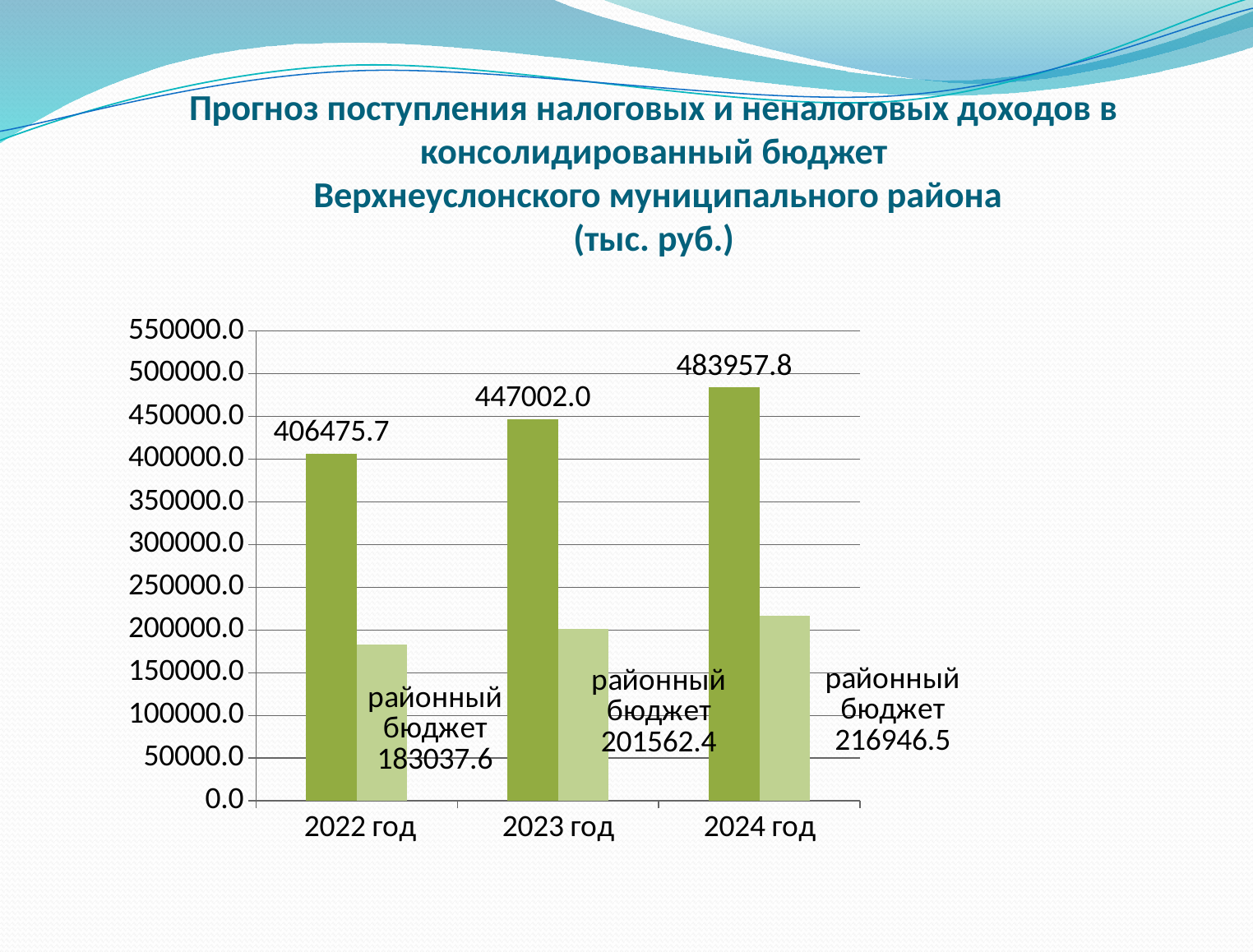
What is the value of the taller (dark green) bar for 2023 год? 447002.0 What is the районный бюджет value for 2022 год? 183037.6 What is the районный бюджет value for 2024 год? 216946.5 What is the value of the taller (dark green) bar for 2022 год? 406475.7 What is the difference between the dark green bar values for 2024 год and 2022 год? 77482.1 What is the value of the taller (dark green) bar for 2024 год? 483957.8 Is the районный бюджет value for 2023 год greater or less than 250000.0? less How many year categories are shown on the x axis? 3 What type of chart is shown on the slide? Bar chart Do the районный бюджет values rise or fall from 2022 год to 2024 год? Rise Which year has the highest value for the dark green bars? 2024 год Which year has the lowest районный бюджет value? 2022 год